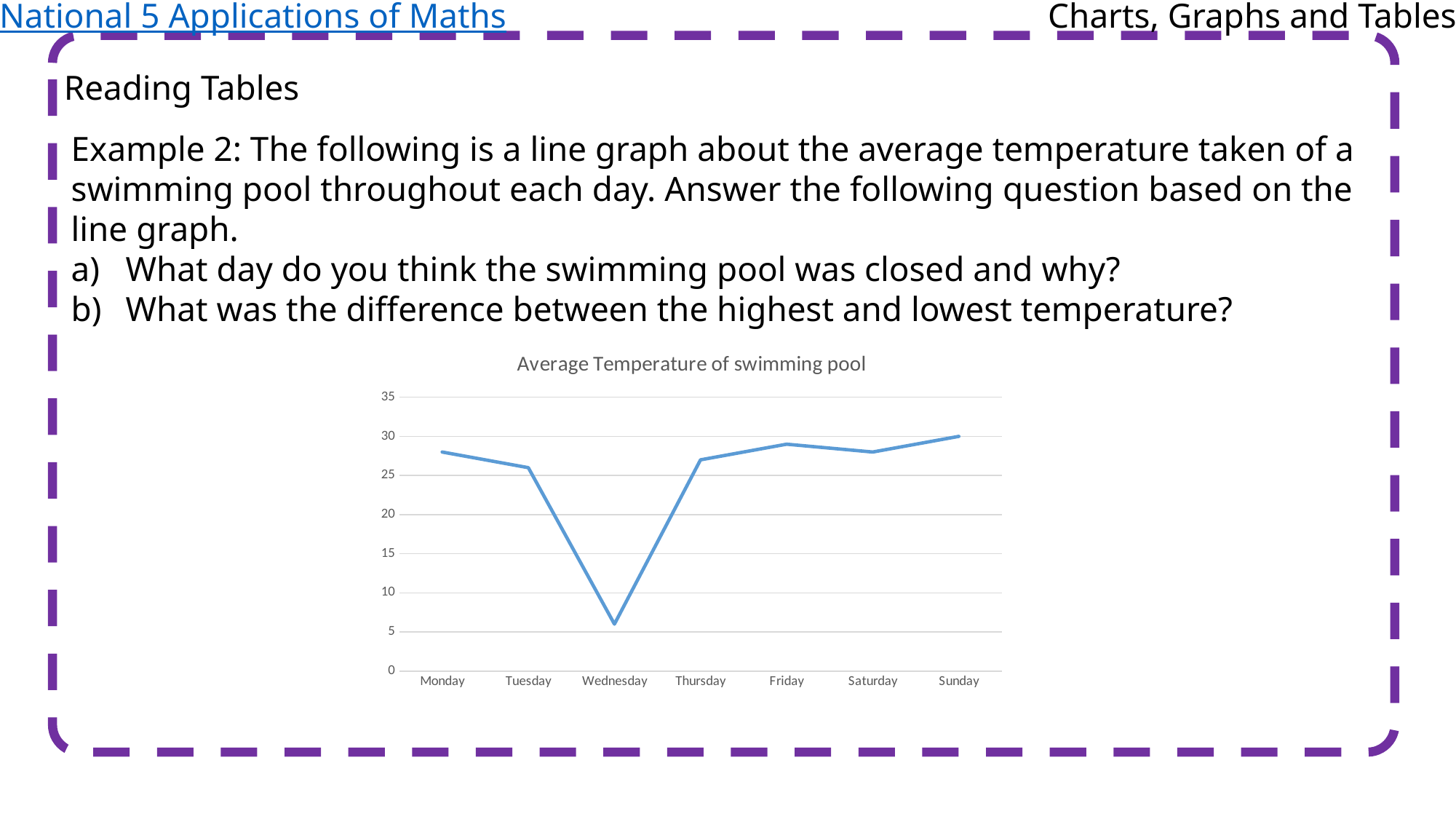
What is the title of the chart? Average Temperature of swimming pool What kind of chart is shown on the slide? line chart Do the values rise or fall from Wednesday to Thursday? rise Which day has the highest average temperature? Sunday Is the value for Monday greater or less than 25? greater Which is larger, the value for Monday or the value for Wednesday? Monday How many days are plotted on the x axis of the chart? 7 Is the value for Friday greater or less than 30? less Which is larger, the value for Sunday or the value for Tuesday? Sunday Is the value for Thursday greater or less than 25? greater Which day has the lowest average temperature? Wednesday